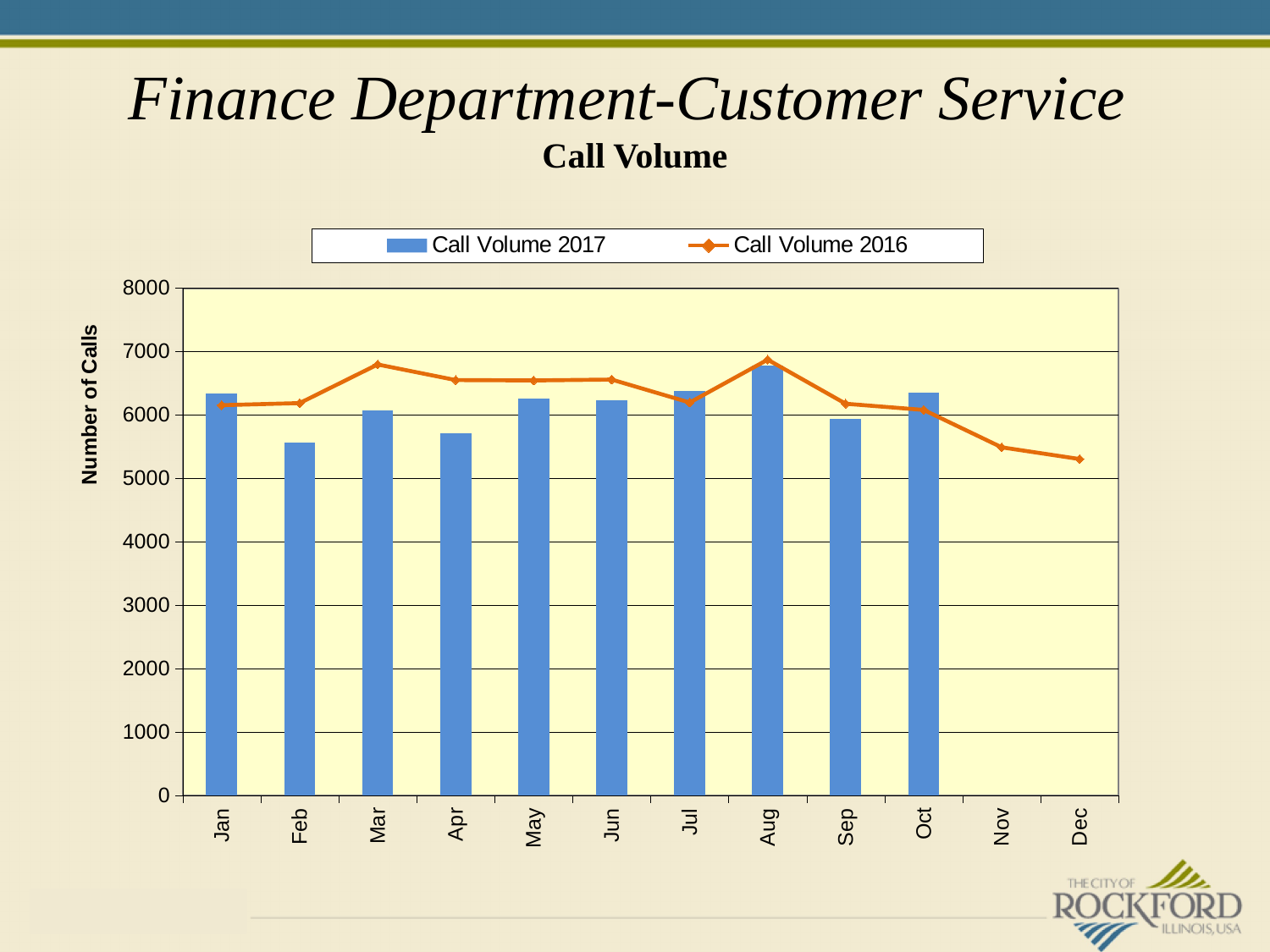
How many series does the legend list? 2 How many months are shown on the x axis? 12 Does Call Volume 2016 rise or fall from Oct to Dec? fall Is the Call Volume 2016 for Mar greater or less than 6000? greater In Apr, which is larger: Call Volume 2016 or Call Volume 2017? Call Volume 2016 Which month has the highest Call Volume 2017? Aug Which month has the lowest Call Volume 2017? Feb What kind of chart is used to show Call Volume 2017? bar chart Is the Call Volume 2017 for Feb greater or less than 6000? less Which month has the lowest Call Volume 2016? Dec Is the Call Volume 2016 for Dec greater or less than 6000? less How many months have a Call Volume 2017 bar? 10